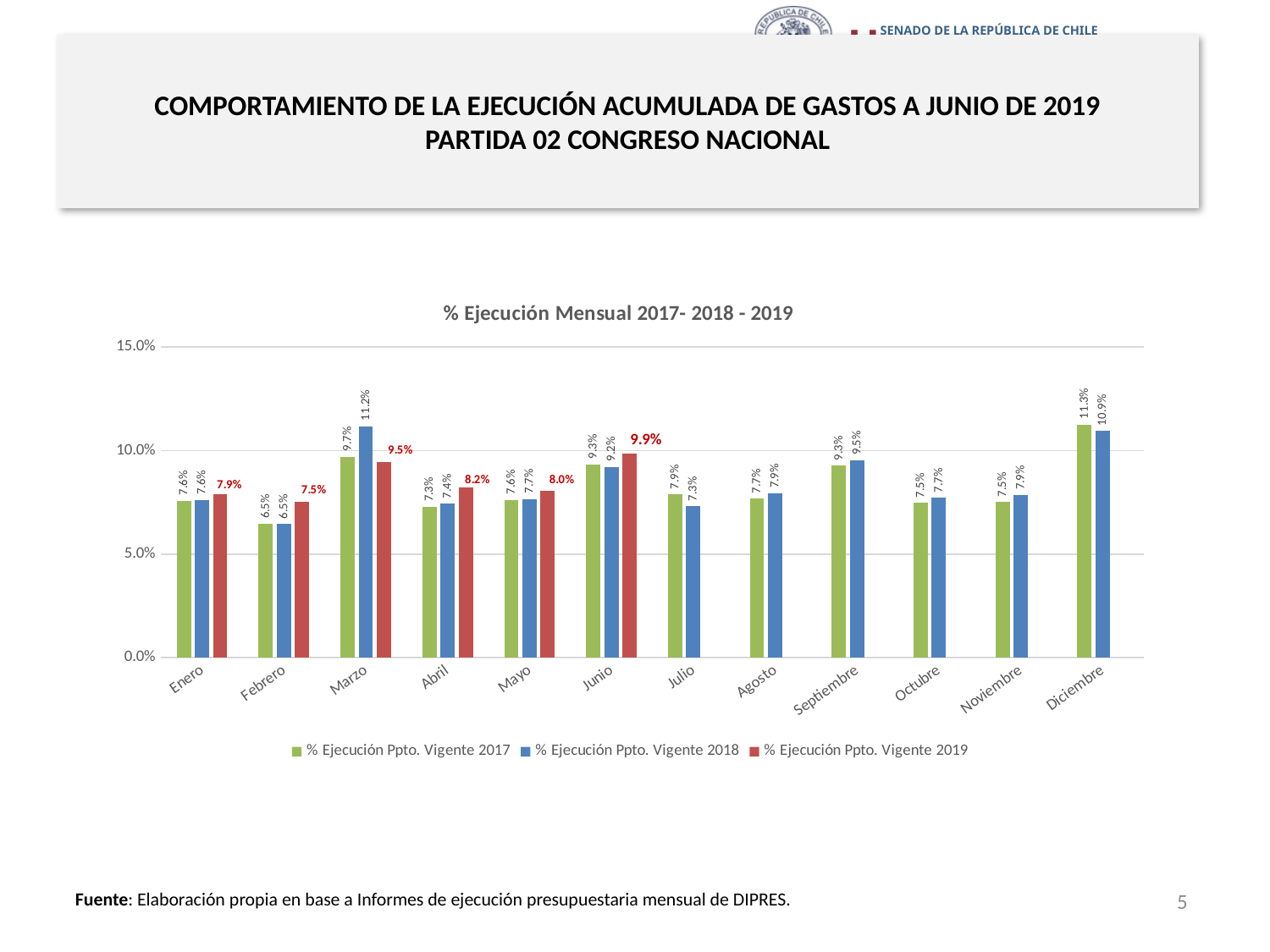
How many months are shown on the x axis? 12 How many series does the legend list? 3 What is the value for % Ejecución Ppto. Vigente 2018 in Diciembre? 10.9% Which is larger in Junio: the 2019 value or the 2017 value? 2019 What is the title of the chart? % Ejecución Mensual 2017- 2018 - 2019 Which month has the lowest value for % Ejecución Ppto. Vigente 2019? Febrero What is the value for % Ejecución Ppto. Vigente 2019 in Marzo? 9.5% Is the value for % Ejecución Ppto. Vigente 2017 in Diciembre greater or less than 10.0%? greater What kind of chart is shown on the slide? Bar chart What is the value for % Ejecución Ppto. Vigente 2017 in Septiembre? 9.3% Which month has the highest value for % Ejecución Ppto. Vigente 2018? Marzo What is the difference between the 2018 and 2017 values in Marzo? 1.5%